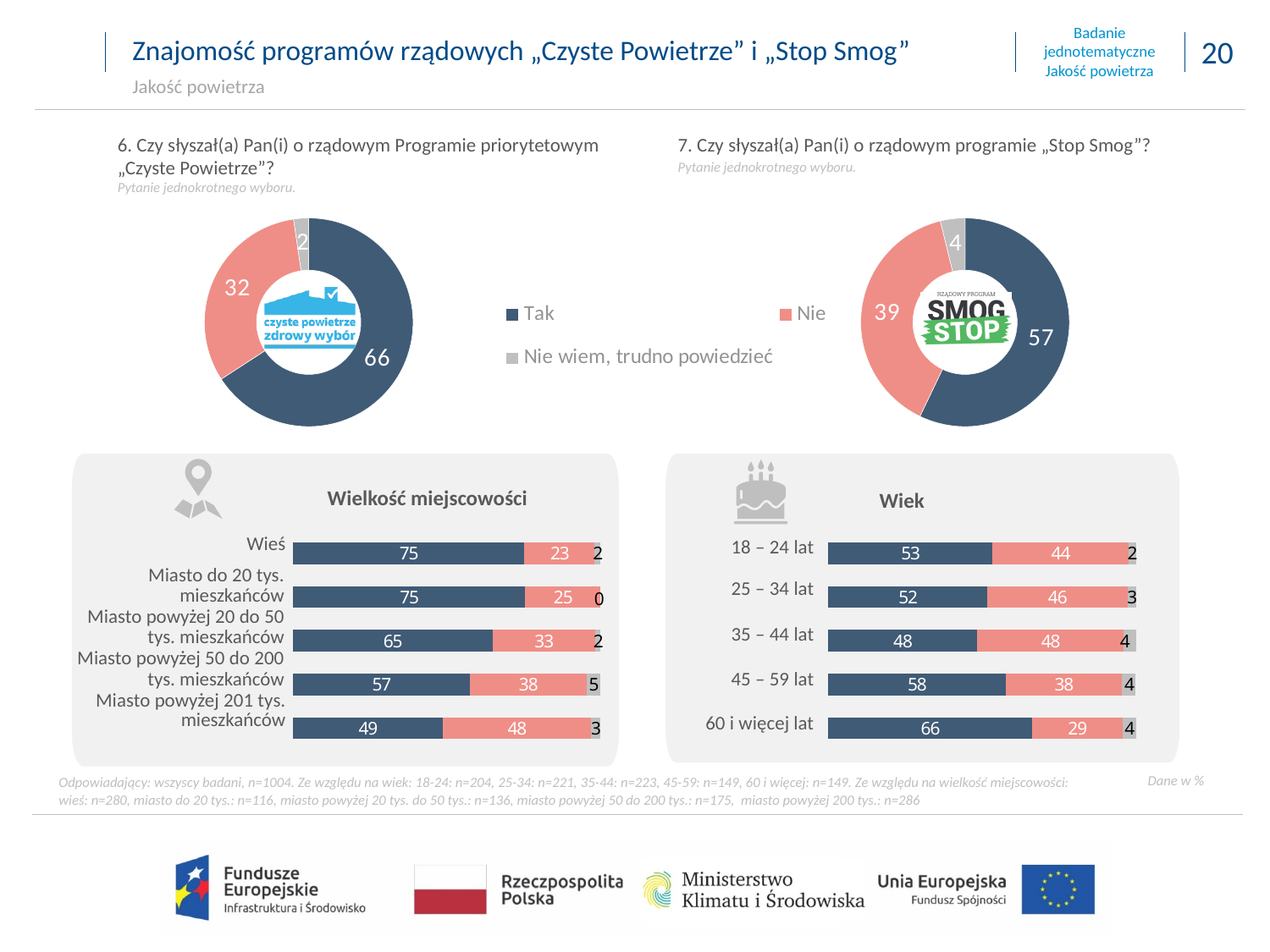
In the "Wielkość miejscowości" bar chart, what is the first (dark blue) value for "Miasto powyżej 201 tys. mieszkańców"? 49 In the donut chart for question 7 about the "Stop Smog" programme, what percentage answered "Nie"? 39 In the "Wielkość miejscowości" bar chart, which category has the highest value in the middle (pink) segment? Miasto powyżej 201 tys. mieszkańców In the "Wiek" bar chart, which age group has the highest value in the first (dark blue) segment? 60 i więcej lat In the donut chart for question 7 about "Stop Smog", what is the value for "Nie wiem, trudno powiedzieć"? 4 In the donut chart for question 6 about the "Czyste Powietrze" programme, what percentage answered "Tak"? 66 How many age categories are shown in the "Wiek" bar chart? 5 How many series does the shared legend between the two donut charts list? 3 In the "Wielkość miejscowości" bar chart, what is the total of the three segments for "Wieś"? 100 In the "Wiek" bar chart, what is the difference between the first (dark blue) segment values for "60 i więcej lat" and "35 – 44 lat"? 18 What is the difference between the "Tak" values in the "Czyste Powietrze" donut chart and the "Stop Smog" donut chart? 9 Comparing the two donut charts, which programme has the higher "Tak" share: "Czyste Powietrze" or "Stop Smog"? Czyste Powietrze